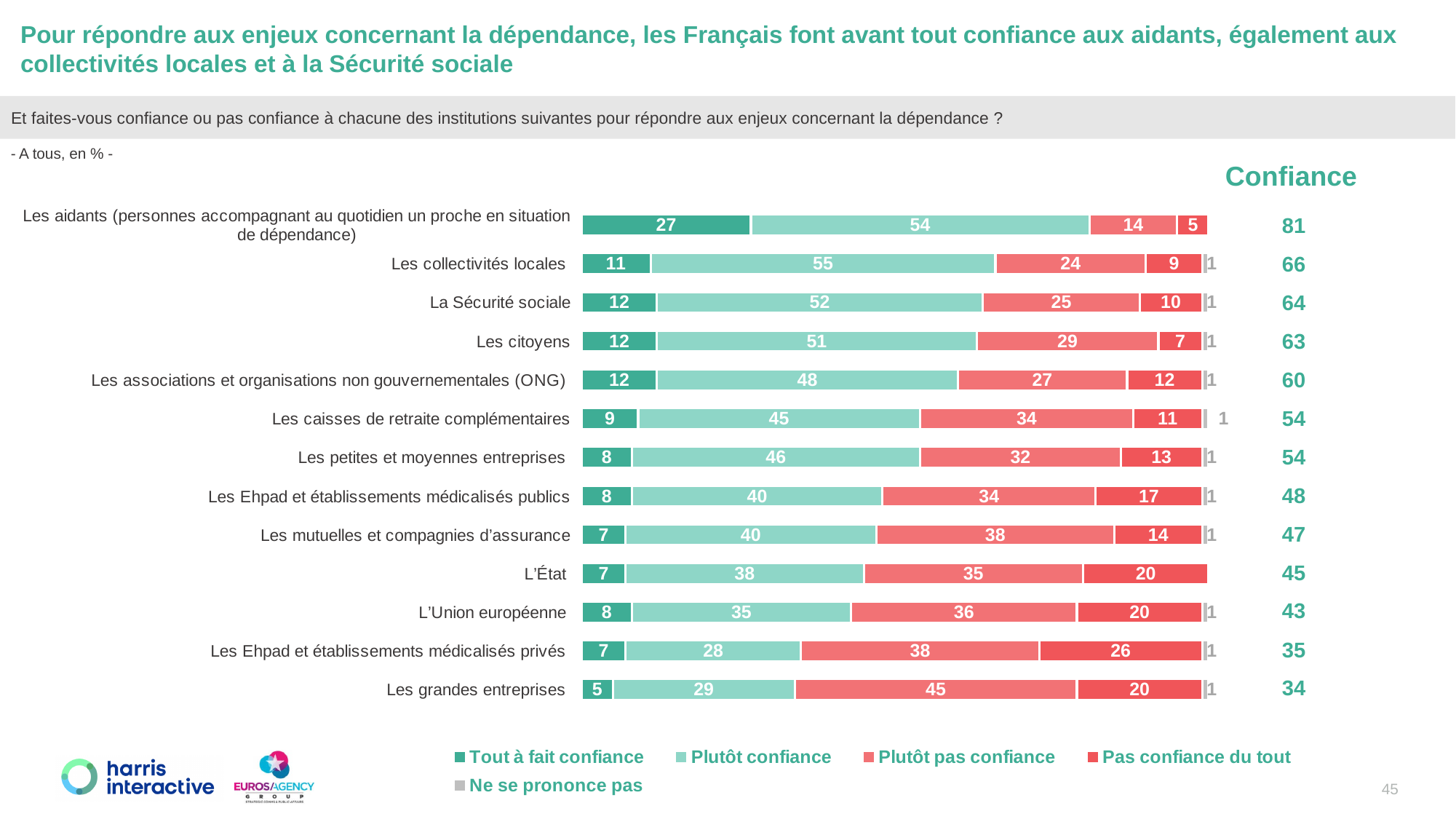
What is the 'Tout à fait confiance' value for 'Les aidants'? 27 Which institution has the lowest 'Confiance' total? Les grandes entreprises What is the 'Plutôt pas confiance' value for 'Les grandes entreprises'? 45 What kind of chart is shown on the slide? bar chart What colour represents 'Ne se prononce pas' in the legend? grey Which has the larger 'Plutôt confiance' value: 'Les collectivités locales' or 'La Sécurité sociale'? Les collectivités locales Which institution has the highest 'Confiance' total? Les aidants How many institutions (categories) are plotted in the chart? 13 What is the 'Pas confiance du tout' value for 'Les Ehpad et établissements médicalisés privés'? 26 How many series does the legend list? 5 What is the difference between the 'Confiance' total for 'Les aidants' (81) and for 'Les grandes entreprises' (34)? 47 What is the total of the stacked bar for 'Les aidants' (27 + 54 + 14 + 5)? 100